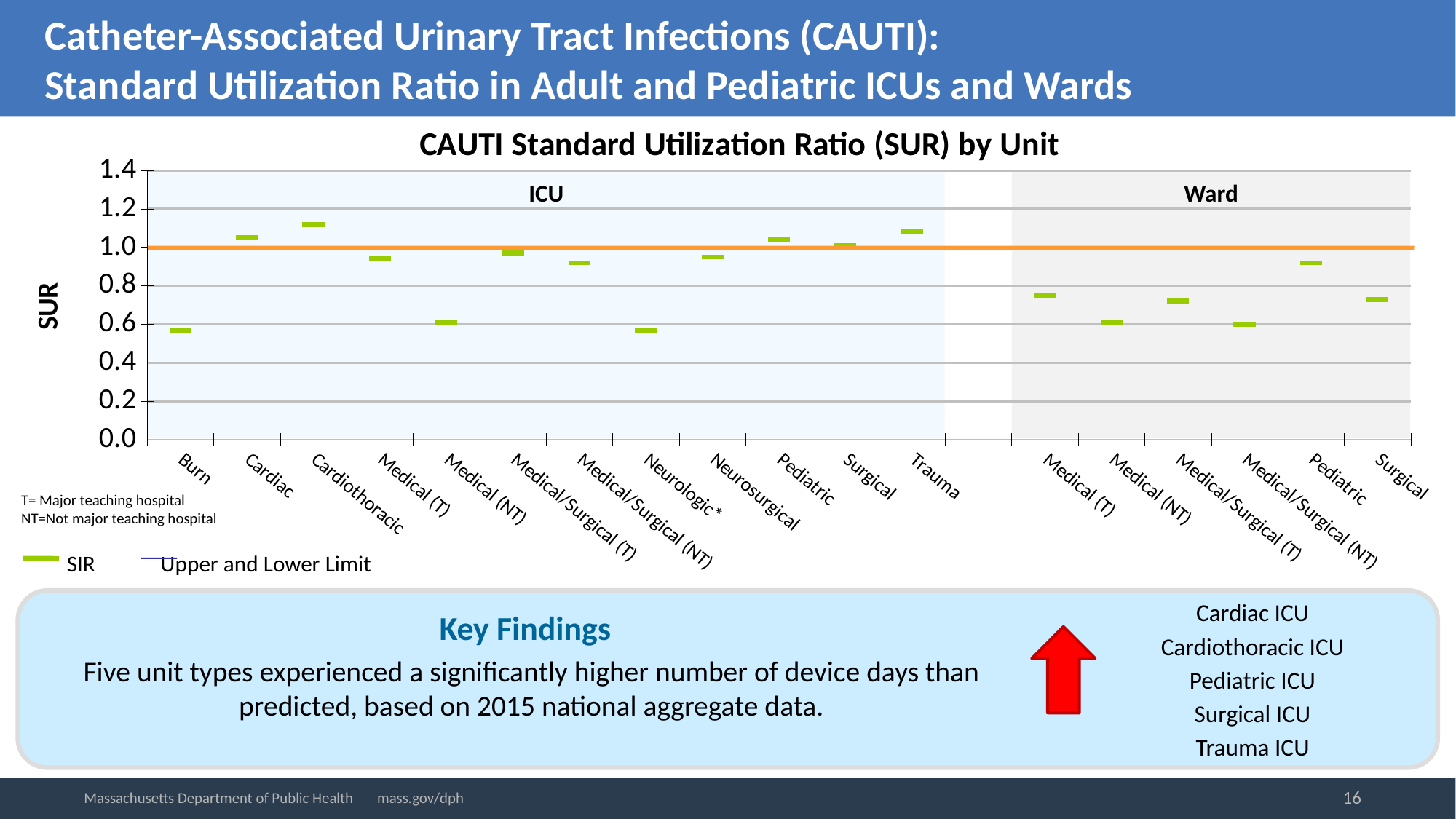
What is the title of the chart? CAUTI Standard Utilization Ratio (SUR) by Unit What is the label on the vertical axis of the chart? SUR Is the SUR value for the Cardiothoracic ICU greater or less than 1.0? greater Which has the larger SUR value: the Pediatric ward or the Medical (NT) ward? Pediatric ward Is the SUR value for the Pediatric ward greater or less than 1.0? less Which unit has the highest SUR value in the chart? Cardiothoracic (ICU) How many unit categories are plotted along the x axis of the chart? 18 How many unit categories are shown in the Ward section of the chart? 6 Is the SUR value for the Burn ICU greater or less than 0.8? less How many unit categories are shown in the ICU section of the chart? 12 How many series does the chart legend list? 2 Which has the larger SUR value: the Cardiac ICU or the Burn ICU? Cardiac ICU